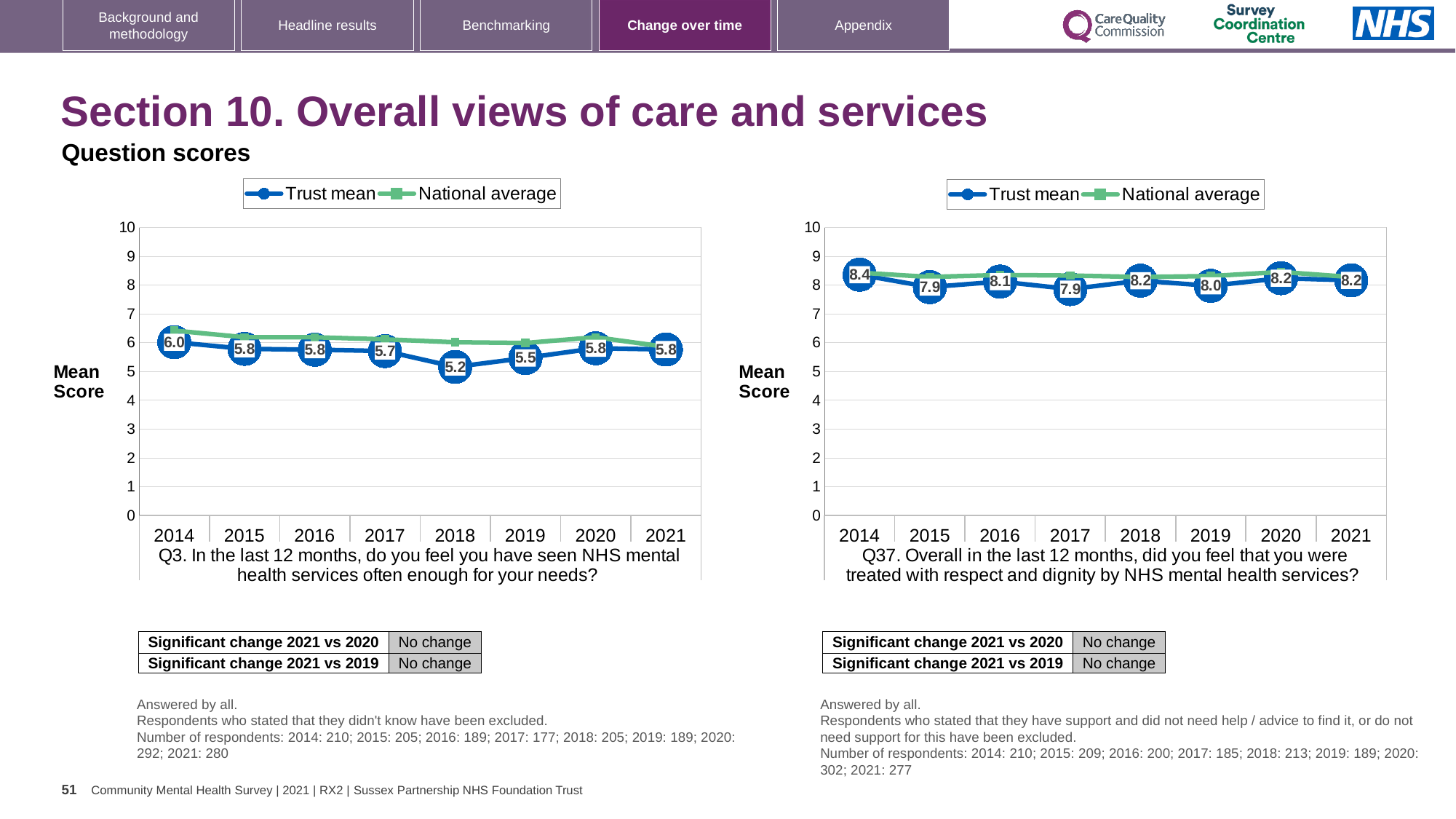
In the right chart (Q37), how many years are shown on the x axis? 8 In the left chart (Q3), which year has the lowest Trust mean score? 2018 In the right chart (Q37), what is the Trust mean score for 2015? 7.9 In the left chart (Q3), what is the Trust mean score for 2014? 6.0 How many series does the legend of the left chart (Q3) list? 2 In the right chart (Q37), which year has the highest Trust mean score? 2014 In the right chart (Q37), what is the Trust mean score for 2021? 8.2 What type of chart is the right chart (Q37)? Line chart In the left chart (Q3), what is the Trust mean score for 2018? 5.2 In the left chart (Q3), what is the difference between the Trust mean scores for 2014 and 2018? 0.8 In the left chart (Q3), which year has the highest Trust mean score? 2014 In the right chart (Q37), is the Trust mean score for 2019 greater or less than 7? greater